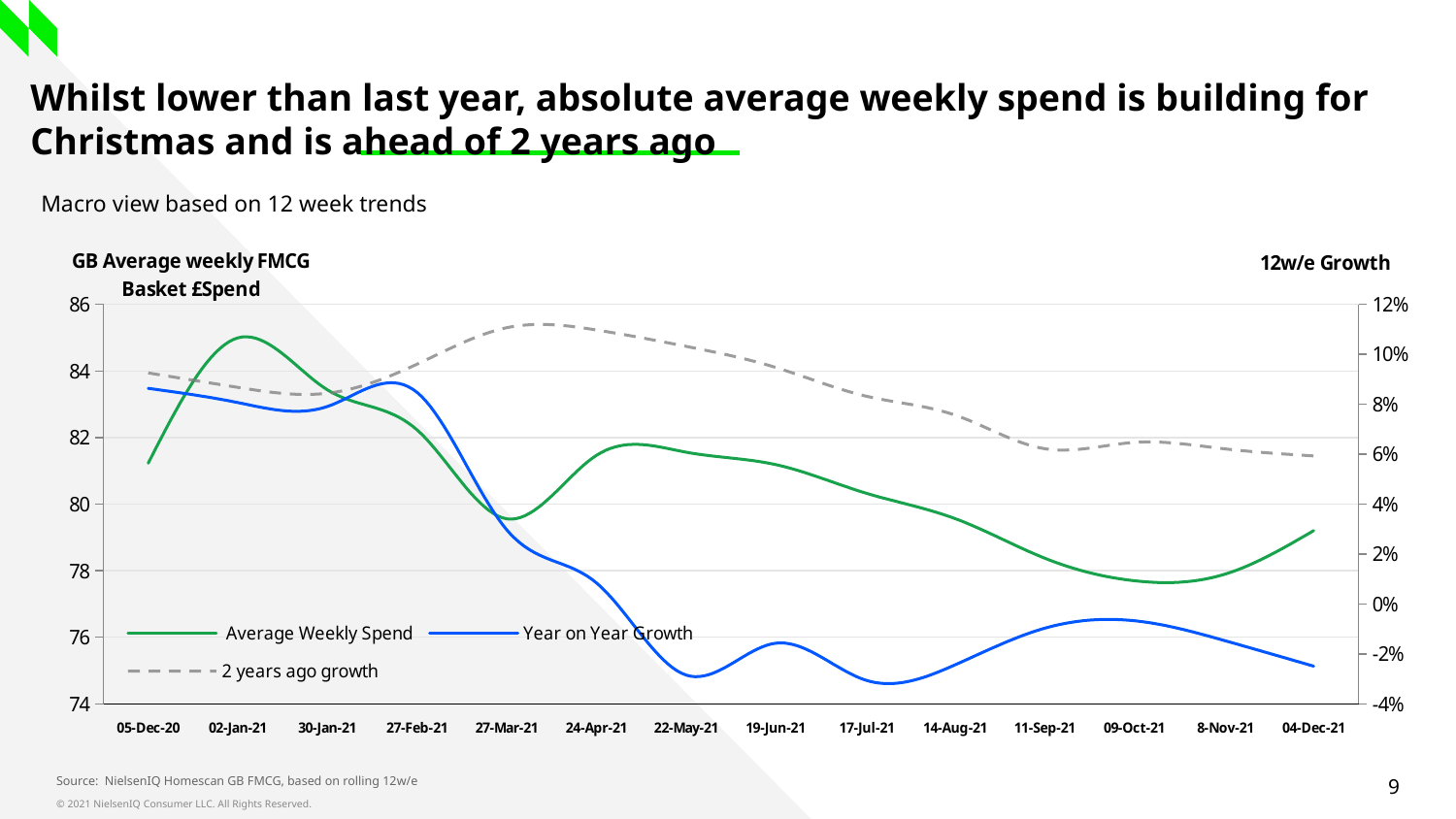
How many series does the chart legend list? 3 At 04-Dec-21, which is higher: 2 years ago growth or Year on Year Growth? 2 years ago growth Is the Year on Year Growth value for 04-Dec-21 greater or less than 0%? less Is the Year on Year Growth value for 05-Dec-20 greater or less than 8%? greater Is the Average Weekly Spend value for 05-Dec-20 greater or less than 82? less On which date does the Average Weekly Spend line reach its highest point? 02-Jan-21 What kind of chart is shown on the slide? line chart Does the Year on Year Growth line overall rise or fall from 05-Dec-20 to 04-Dec-21? fall How many dates are labelled along the x axis of the chart? 14 Which series in the legend is drawn as a dashed line? 2 years ago growth